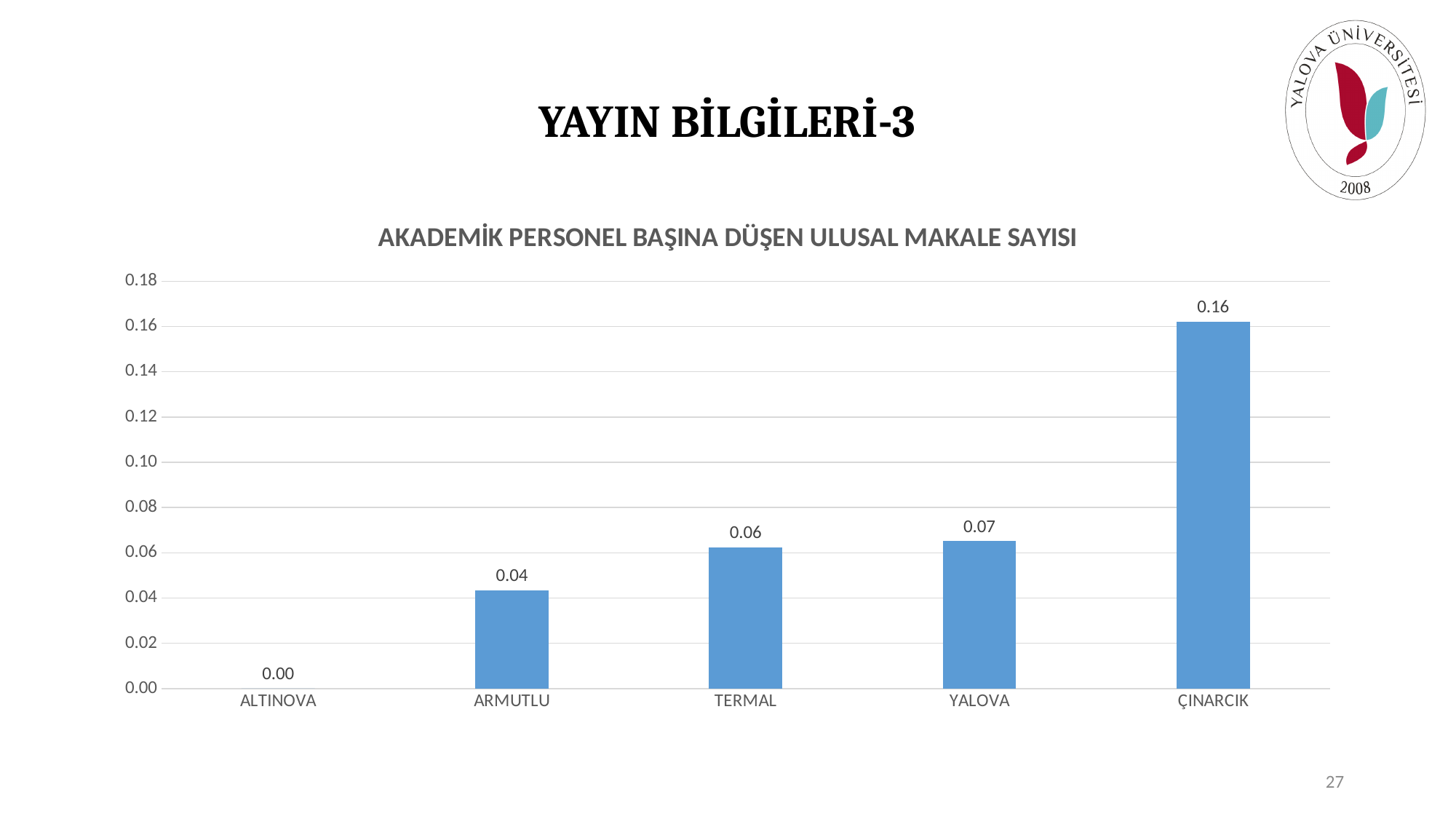
What is the value for ALTINOVA? 0.00 Which category has the highest value? ÇINARCIK What is the difference between the values for ÇINARCIK and YALOVA? 0.09 Is the value for ÇINARCIK greater or less than 0.10? greater What kind of chart is shown on the slide? bar chart What is the value for TERMAL? 0.06 What is the value for ARMUTLU? 0.04 What is the value for ÇINARCIK? 0.16 Which is larger, the value for ARMUTLU or the value for YALOVA? YALOVA Which category has the lowest value? ALTINOVA What is the title of the chart? AKADEMİK PERSONEL BAŞINA DÜŞEN ULUSAL MAKALE SAYISI How many categories are shown on the x axis? 5